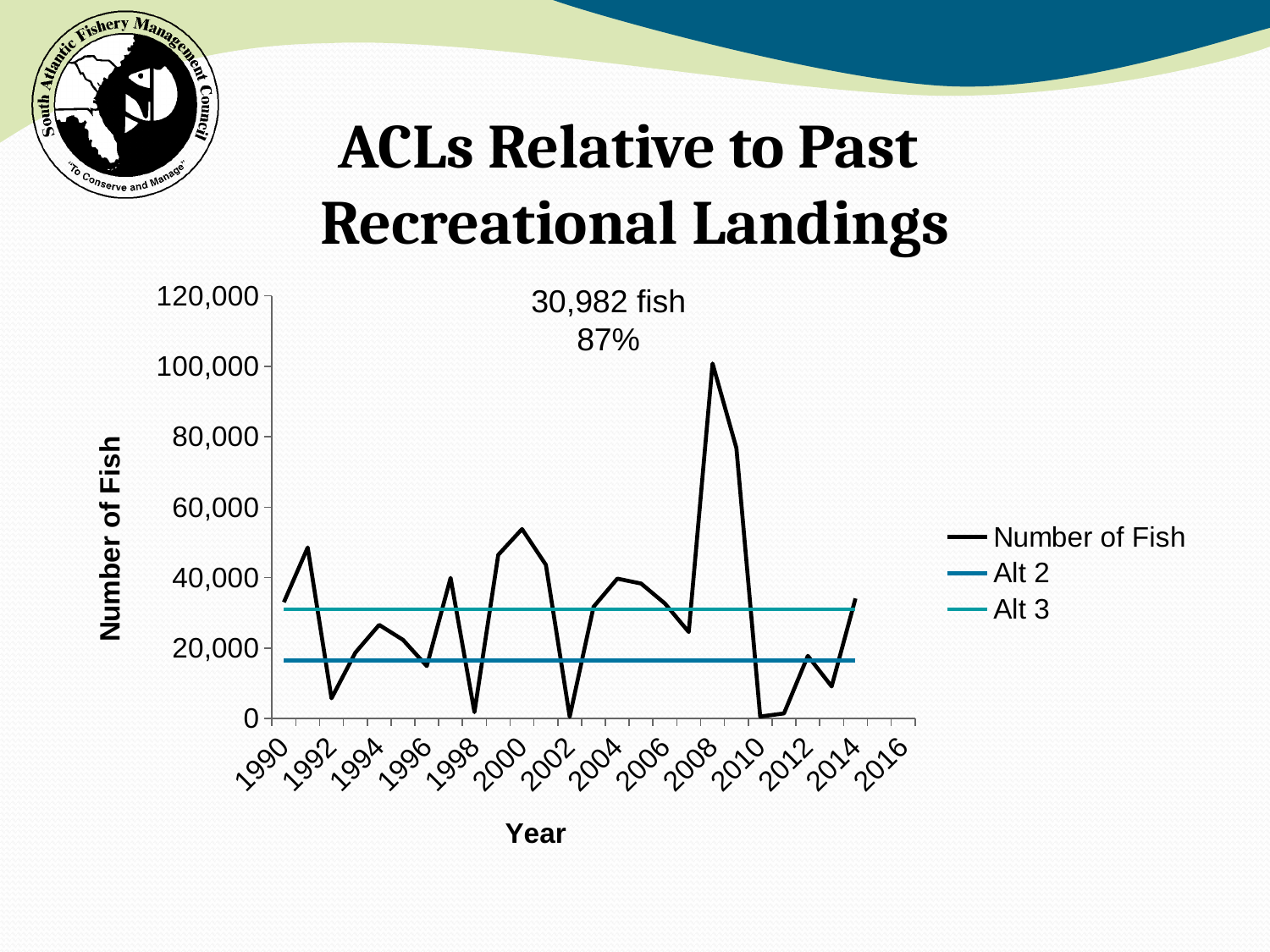
How many series does the legend list? 3 Is the Number of Fish value for 2010 greater or less than 20,000? less What is the title of the chart? ACLs Relative to Past Recreational Landings Is the Number of Fish value for 2000 greater or less than 40,000? greater Is the Number of Fish value for 2008 greater or less than 80,000? greater What value is annotated at the top of the chart? 30,982 fish, 87% In which year does the Number of Fish series reach its highest value? 2008 How many year labels are shown on the x axis? 14 Which is higher on the chart, the Alt 2 line or the Alt 3 line? Alt 3 What kind of chart is shown on the slide? line chart